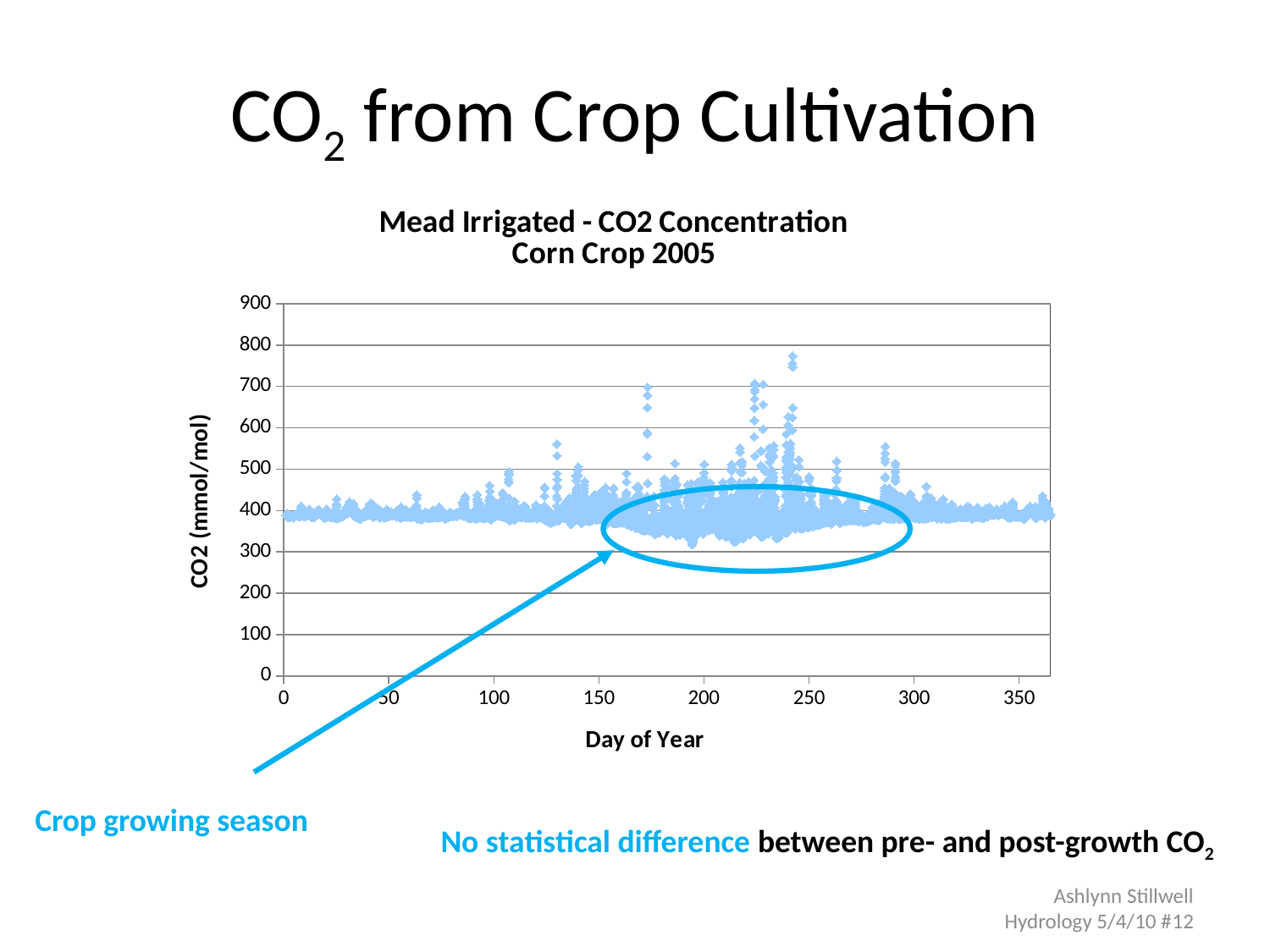
Is the highest CO2 value plotted on the chart greater or less than 700? greater What is the label of the vertical axis of the chart? CO2 (mmol/mol) Are the CO2 values plotted near day 350 greater or less than 500? less What kind of chart is shown on the slide? scatter chart Is the highest CO2 value plotted on the chart greater or less than 800? less What is the title of the chart? Mead Irrigated - CO2 Concentration Corn Crop 2005